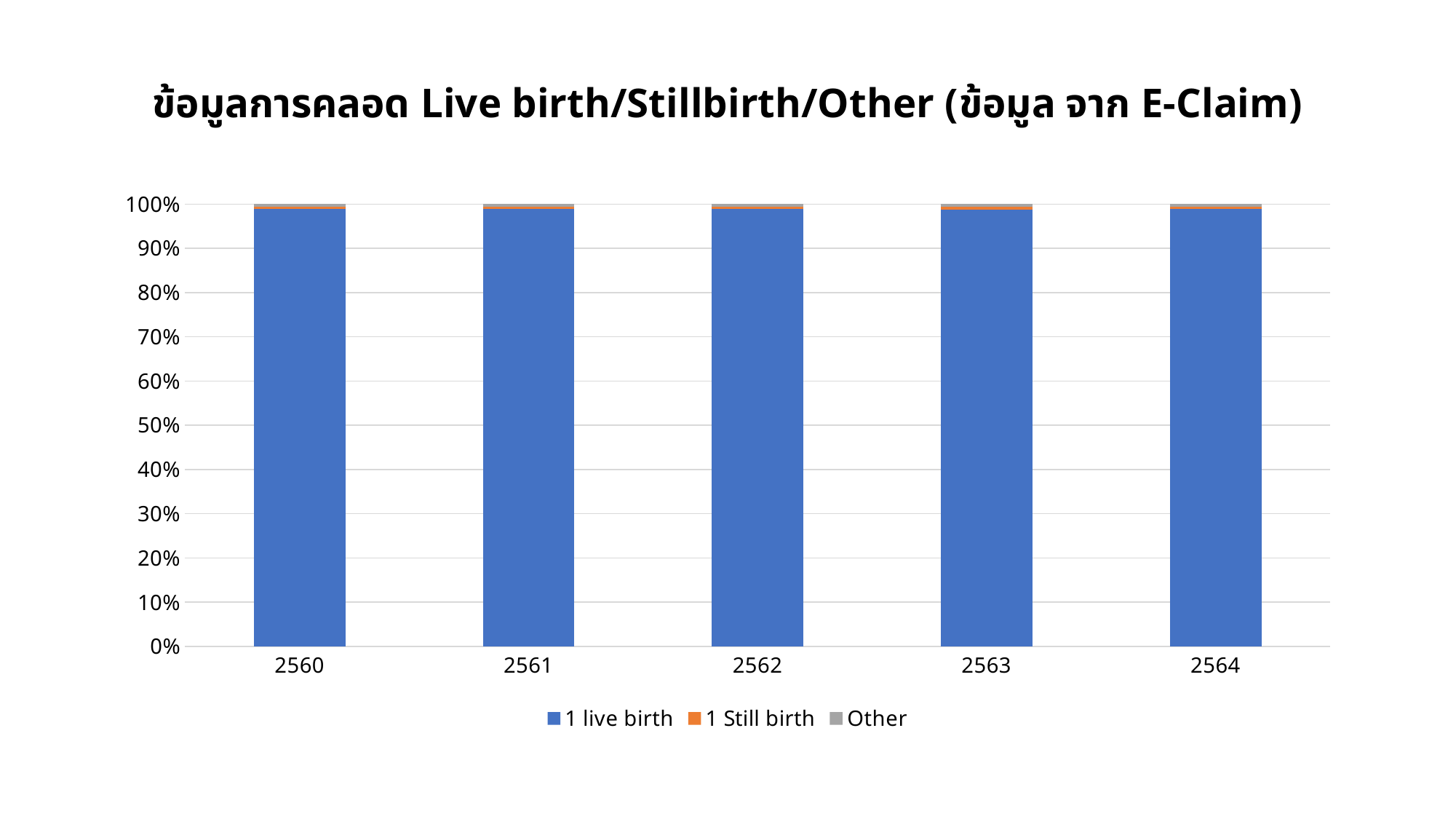
How many series does the legend list? 3 Is the value for Other in 2563 greater or less than 10%? less What is the total height of the stacked bar for 2562? 100% Is the value for 1 live birth in 2560 greater or less than 90%? greater What kind of chart is shown on the slide? Stacked bar chart What is the first year shown on the x axis? 2560 Which colour represents the 1 live birth series in the legend? Blue Which series makes up the largest share of the bar for 2561? 1 live birth How many years (categories) are shown on the x axis? 5 Is the value for 1 live birth in 2564 greater or less than 90%? greater